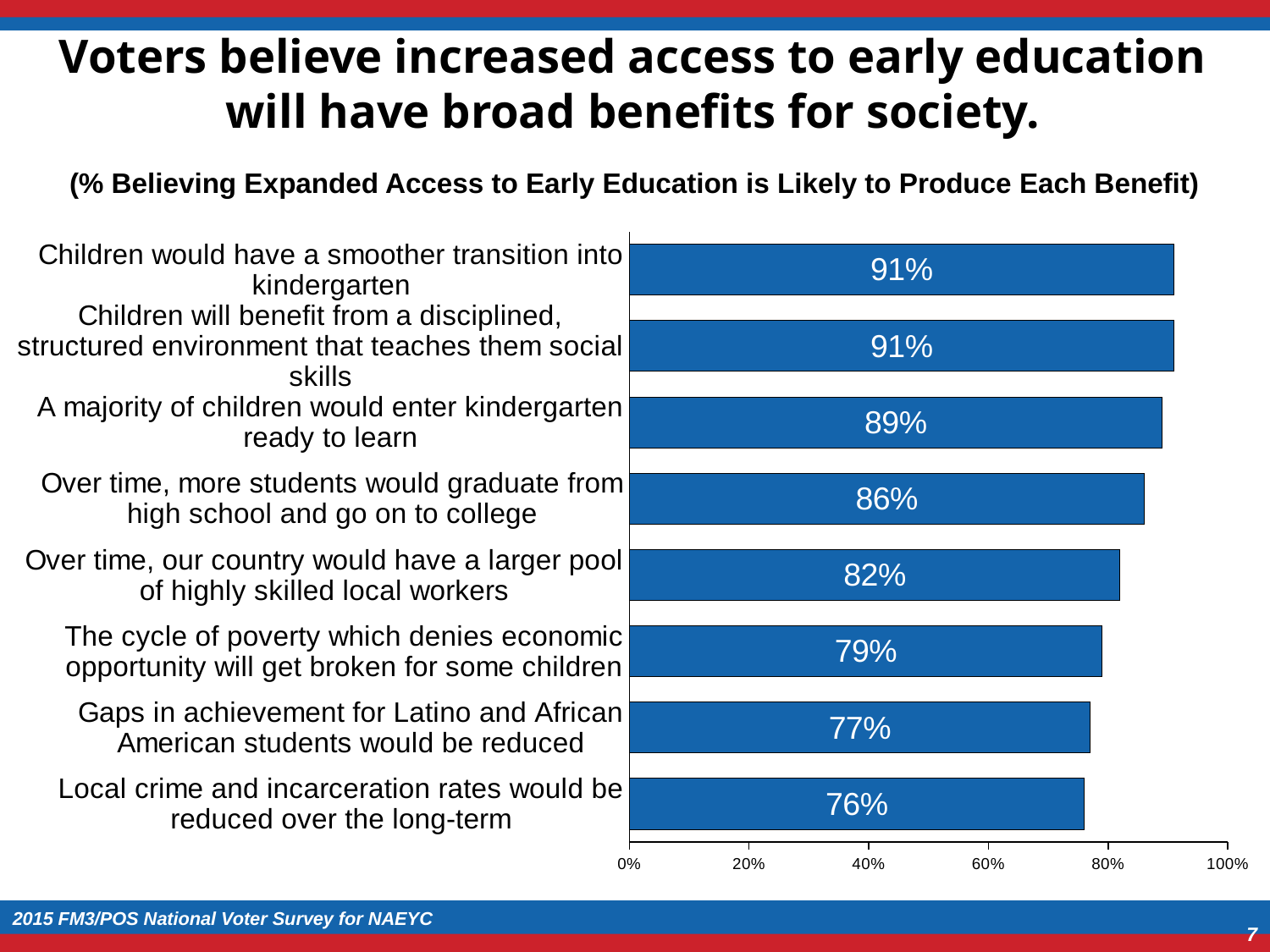
What percentage believe that over time, more students would graduate from high school and go on to college? 86% What type of chart is shown on the slide? bar chart What is the value for 'Gaps in achievement for Latino and African American students would be reduced'? 77% Which is larger: the value for 'Over time, our country would have a larger pool of highly skilled local workers' or the value for 'Local crime and incarceration rates would be reduced over the long-term'? Over time, our country would have a larger pool of highly skilled local workers Which benefit has the lowest percentage of voters believing it is likely? Local crime and incarceration rates would be reduced over the long-term What is the highest value shown on the horizontal axis? 100% What is the difference between the highest value and the lowest value in the chart? 15% What is the difference between the value for 'A majority of children would enter kindergarten ready to learn' and the value for 'The cycle of poverty which denies economic opportunity will get broken for some children'? 10% Is the value for 'The cycle of poverty which denies economic opportunity will get broken for some children' greater or less than 80%? less What percentage of voters believe children would have a smoother transition into kindergarten? 91% What is the value for 'Local crime and incarceration rates would be reduced over the long-term'? 76% How many benefits (categories) are shown in the chart? 8